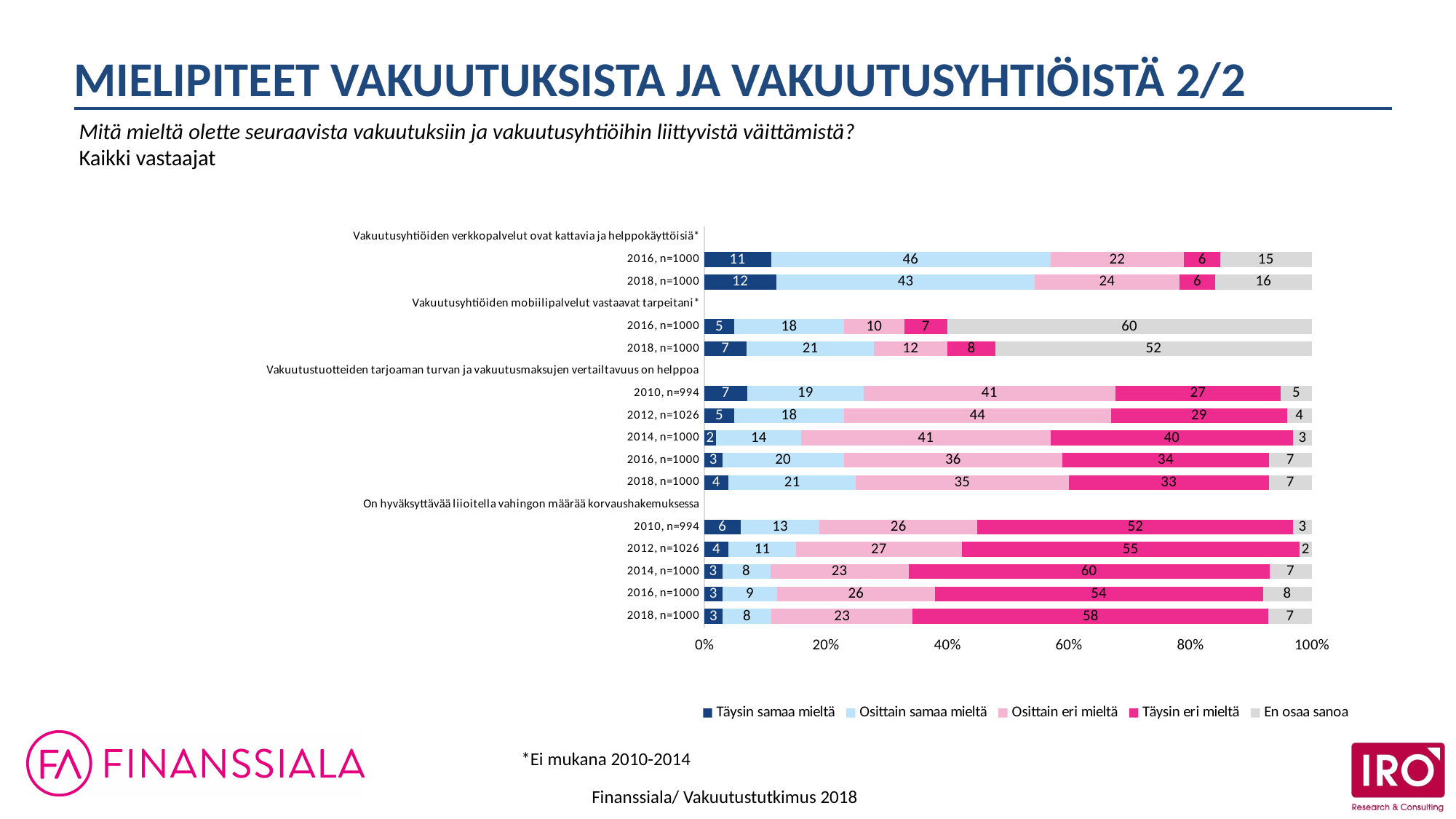
What is the 'En osaa sanoa' value for 'Vakuutusyhtiöiden mobiilipalvelut vastaavat tarpeitani' in 2016, n=1000? 60 What is the difference between the 'En osaa sanoa' values for 'Vakuutusyhtiöiden mobiilipalvelut vastaavat tarpeitani' in 2016 and 2018? 8 How many series does the legend list? 5 Among the rows for 'Vakuutustuotteiden tarjoaman turvan ja vakuutusmaksujen vertailtavuus on helppoa', which year has the lowest 'Täysin samaa mieltä' value? 2014, n=1000 What is the 'Täysin eri mieltä' value for 'On hyväksyttävää liioitella vahingon määrää korvaushakemuksessa' in 2014, n=1000? 60 What type of chart is shown on the slide? Stacked bar chart What is the 'Osittain samaa mieltä' value for 'Vakuutusyhtiöiden verkkopalvelut ovat kattavia ja helppokäyttöisiä' in 2016, n=1000? 46 Which is larger: the 'Osittain eri mieltä' value for 'Vakuutustuotteiden tarjoaman turvan ja vakuutusmaksujen vertailtavuus on helppoa' in 2012, n=1026, or in 2018, n=1000? 2012, n=1026 What is the total of the stacked bar for 'Vakuutusyhtiöiden verkkopalvelut ovat kattavia ja helppokäyttöisiä' in 2018, n=1000? 101 Among the rows for 'On hyväksyttävää liioitella vahingon määrää korvaushakemuksessa', which year has the highest 'Täysin eri mieltä' value? 2014, n=1000 Which legend entry is shown in the darkest blue colour? Täysin samaa mieltä How many bars (year rows) are plotted in the chart? 14